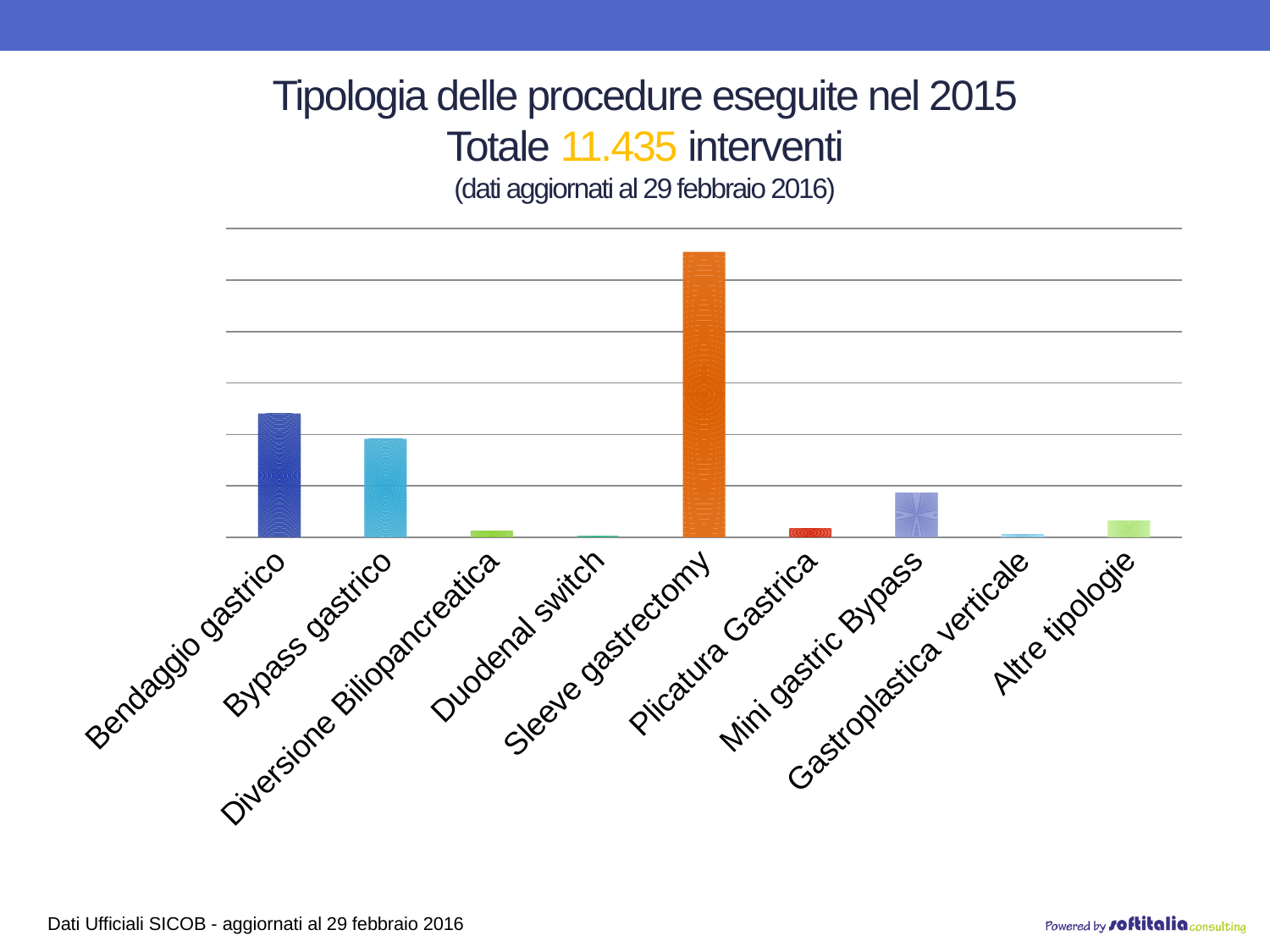
What is the first line of the chart's title? Tipologia delle procedure eseguite nel 2015 Which procedure category has the highest bar in the chart? Sleeve gastrectomy How many procedure categories are shown on the x axis of the chart? 9 Which bar is taller: Bendaggio gastrico or Bypass gastrico? Bendaggio gastrico According to the slide title, what is the total number of interventi in 2015? 11.435 Which bar is taller: Sleeve gastrectomy or Bendaggio gastrico? Sleeve gastrectomy Which bar is taller: Bypass gastrico or Mini gastric Bypass? Bypass gastrico What kind of chart is shown on the slide? Bar chart